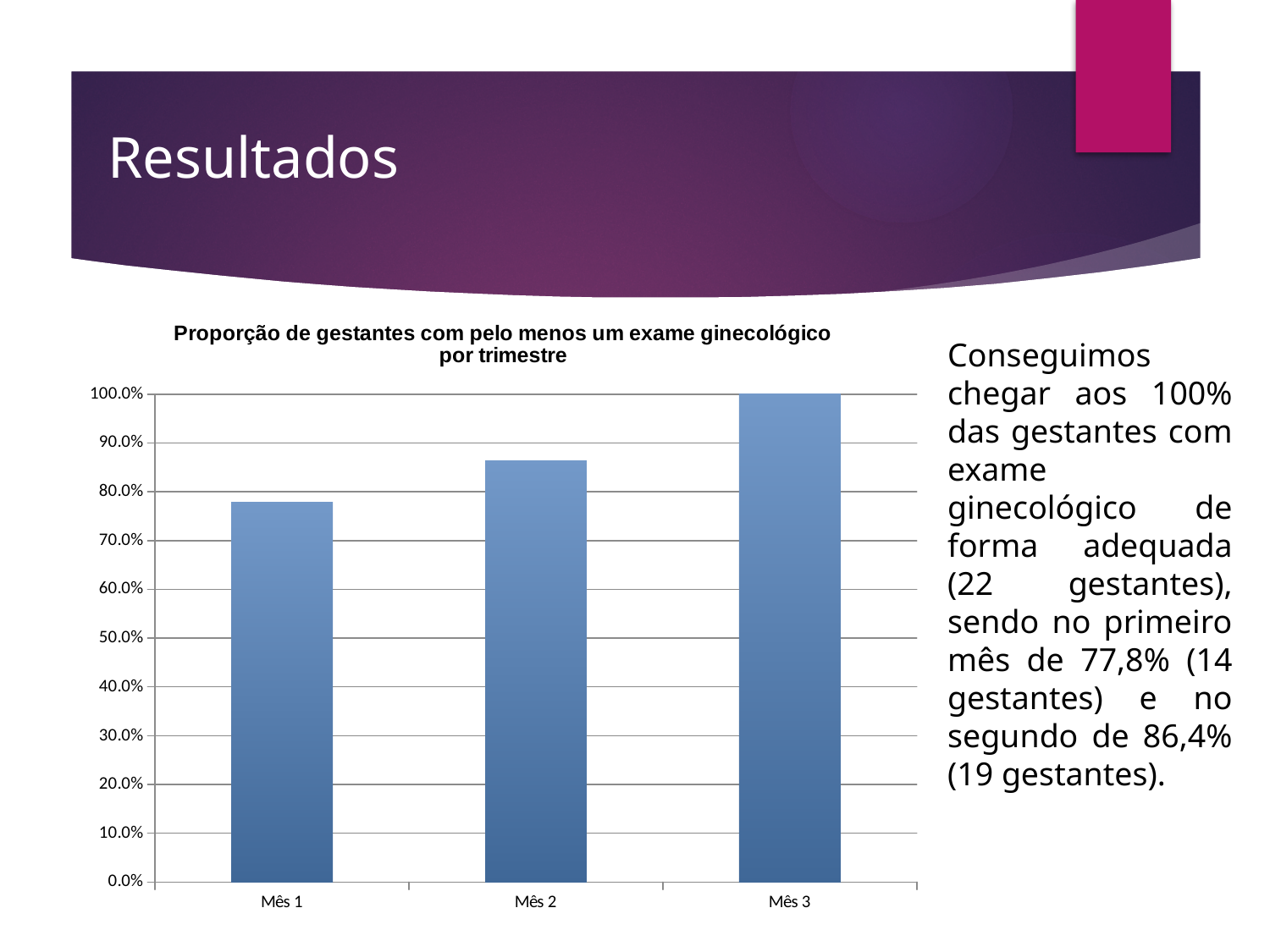
What is the title of the chart? Proporção de gestantes com pelo menos um exame ginecológico por trimestre What is the value for Mês 3 in the chart? 100.0% Is the value for Mês 1 greater or less than 70.0%? greater Do the values rise or fall from Mês 1 to Mês 3? rise How many categories are plotted on the x axis of the chart? 3 What is the highest tick label shown on the y axis of the chart? 100.0% Is the value for Mês 2 greater or less than 80.0%? greater Is the value for Mês 1 greater or less than 80.0%? less Which month has the highest proportion in the chart? Mês 3 What kind of chart is shown on the slide? bar chart Which month has the lowest proportion in the chart? Mês 1 Which is larger, the value for Mês 1 or the value for Mês 2? Mês 2